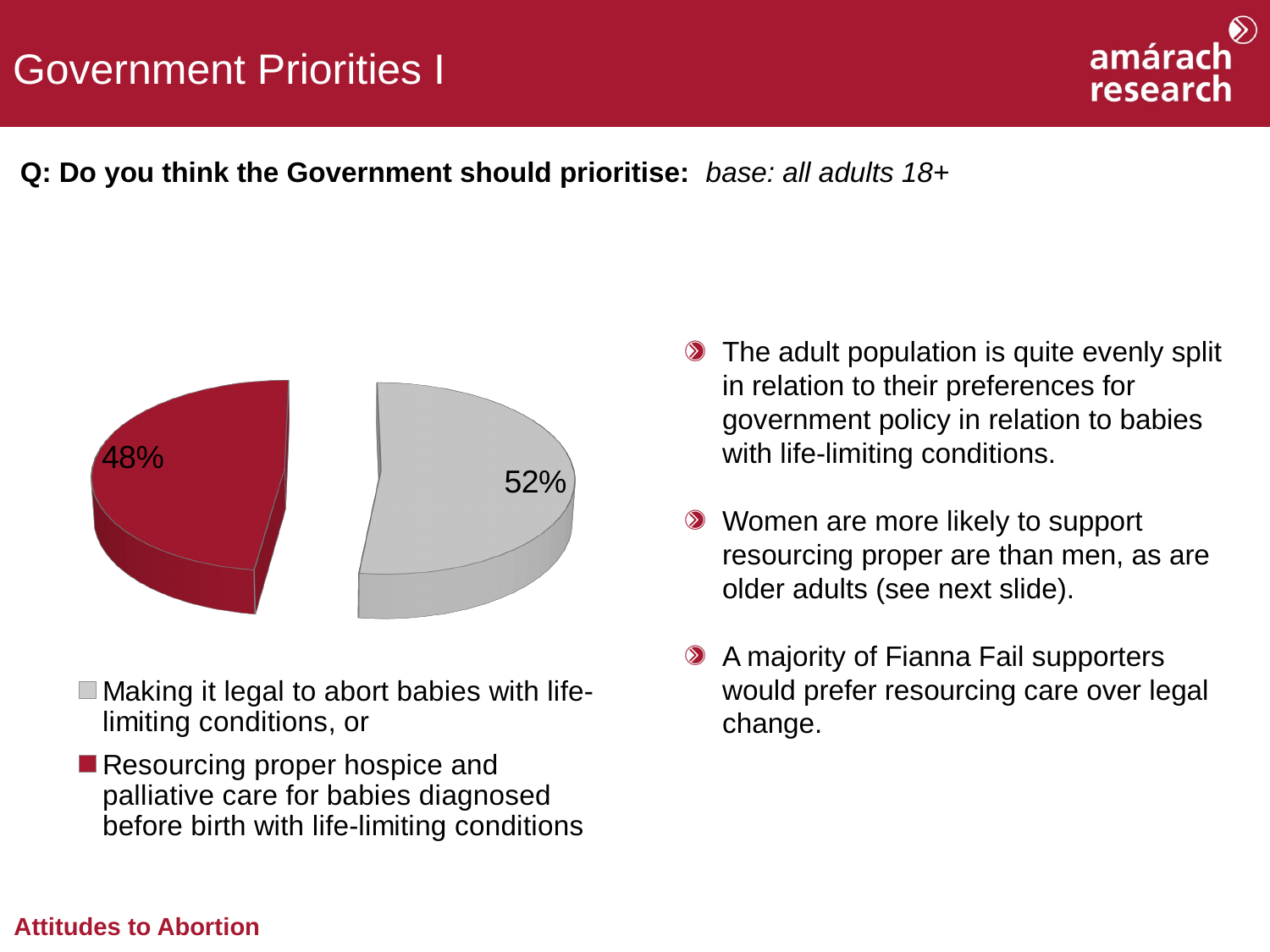
What kind of chart is shown on the slide? Pie chart What is the total of the two percentages shown on the pie chart? 100% How many entries does the legend list? 2 How many slices does the pie chart have? 2 Which option received the larger share of responses? Making it legal to abort babies with life-limiting conditions What is the difference in percentage points between the two slices of the pie chart? 4 percentage points What percentage of adults chose 'Making it legal to abort babies with life-limiting conditions'? 52% Which option received the smaller share of responses? Resourcing proper hospice and palliative care for babies diagnosed before birth with life-limiting conditions What colour is the slice representing 'Making it legal to abort babies with life-limiting conditions'? Grey Is the share for 'Making it legal to abort babies with life-limiting conditions' larger or smaller than the share for 'Resourcing proper hospice and palliative care'? Larger What colour is the slice representing 'Resourcing proper hospice and palliative care'? Red What percentage of adults chose 'Resourcing proper hospice and palliative care for babies diagnosed before birth with life-limiting conditions'? 48%